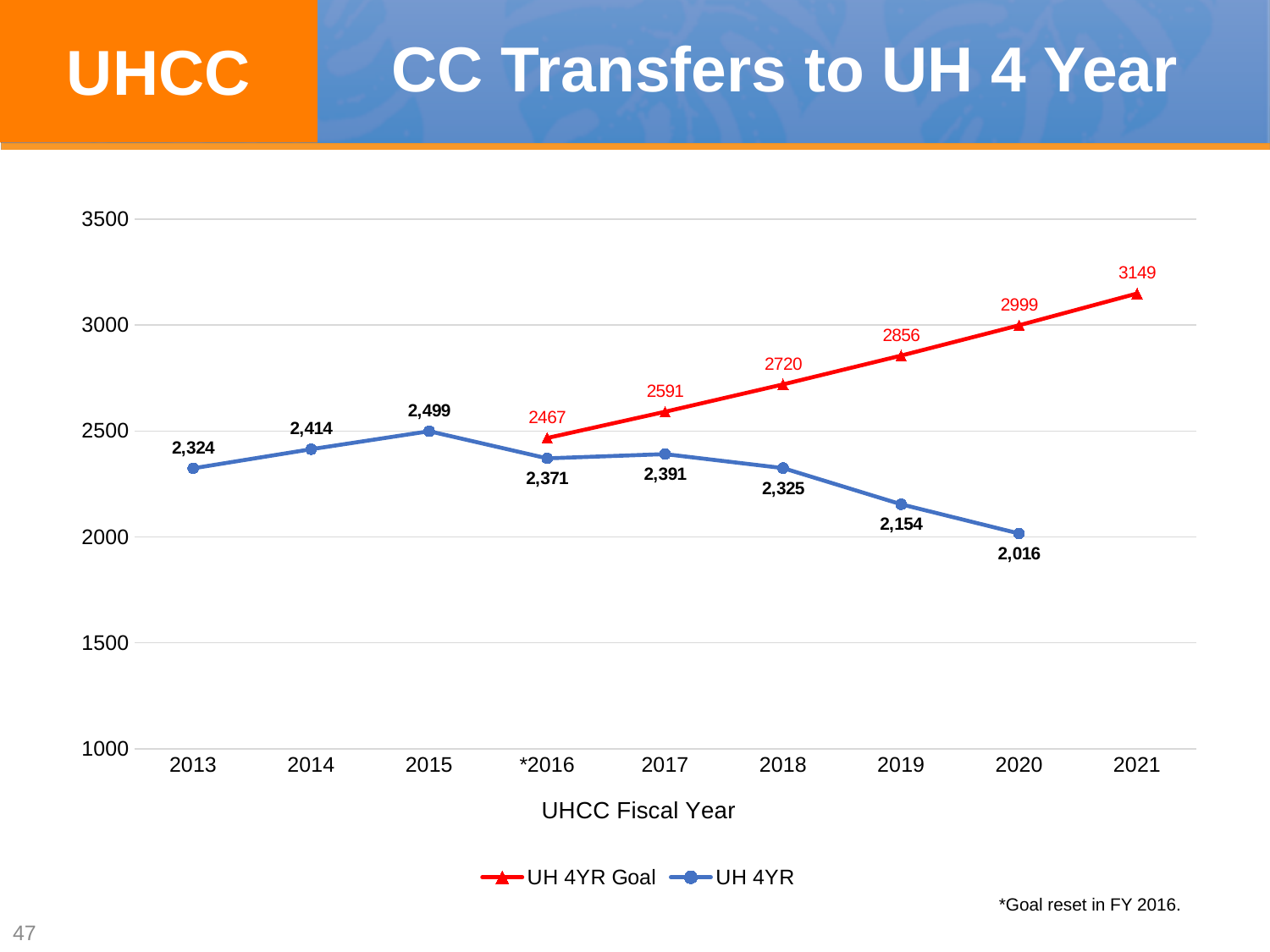
What is the UH 4YR Goal value for 2021? 3149 What is the UH 4YR value for 2015? 2,499 What is the difference between the UH 4YR Goal and the UH 4YR value in 2020? 983 In which year is the UH 4YR series at its lowest? 2020 What kind of chart is shown on the slide? line chart Which is larger in 2018, the UH 4YR Goal or the UH 4YR value? UH 4YR Goal How many series does the legend list? 2 How many fiscal years are shown on the x axis? 9 Is the UH 4YR value for 2019 greater or less than 2500? less In which year is the UH 4YR series at its highest? 2015 Does the UH 4YR Goal series rise or fall from 2016 to 2021? rise What is the UH 4YR value for 2020? 2,016